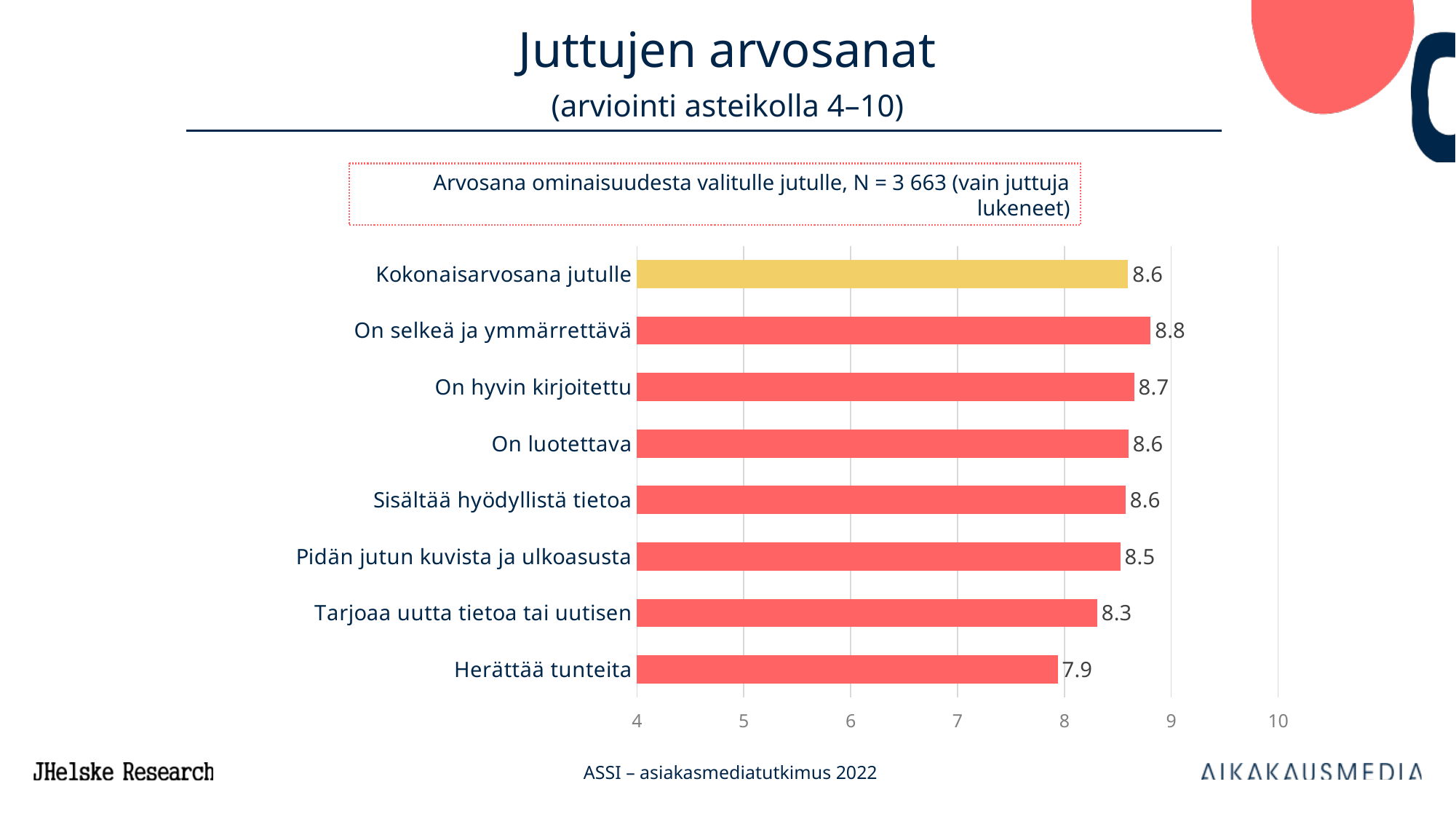
What is the value for "Tarjoaa uutta tietoa tai uutisen"? 8.3 What is the difference between the values for "On selkeä ja ymmärrettävä" and "Herättää tunteita"? 0.9 How many categories are shown in the chart? 8 What is the value for "On selkeä ja ymmärrettävä"? 8.8 Which is larger, the value for "On hyvin kirjoitettu" or the value for "Pidän jutun kuvista ja ulkoasusta"? On hyvin kirjoitettu Which category's bar is shown in a different colour (yellow) from the others? Kokonaisarvosana jutulle Is the value for "Herättää tunteita" greater or less than 8? less What is the value for "Herättää tunteita"? 7.9 What kind of chart is shown on the slide? bar chart What is the value for "Kokonaisarvosana jutulle"? 8.6 Which category has the lowest value? Herättää tunteita Which category has the highest value? On selkeä ja ymmärrettävä